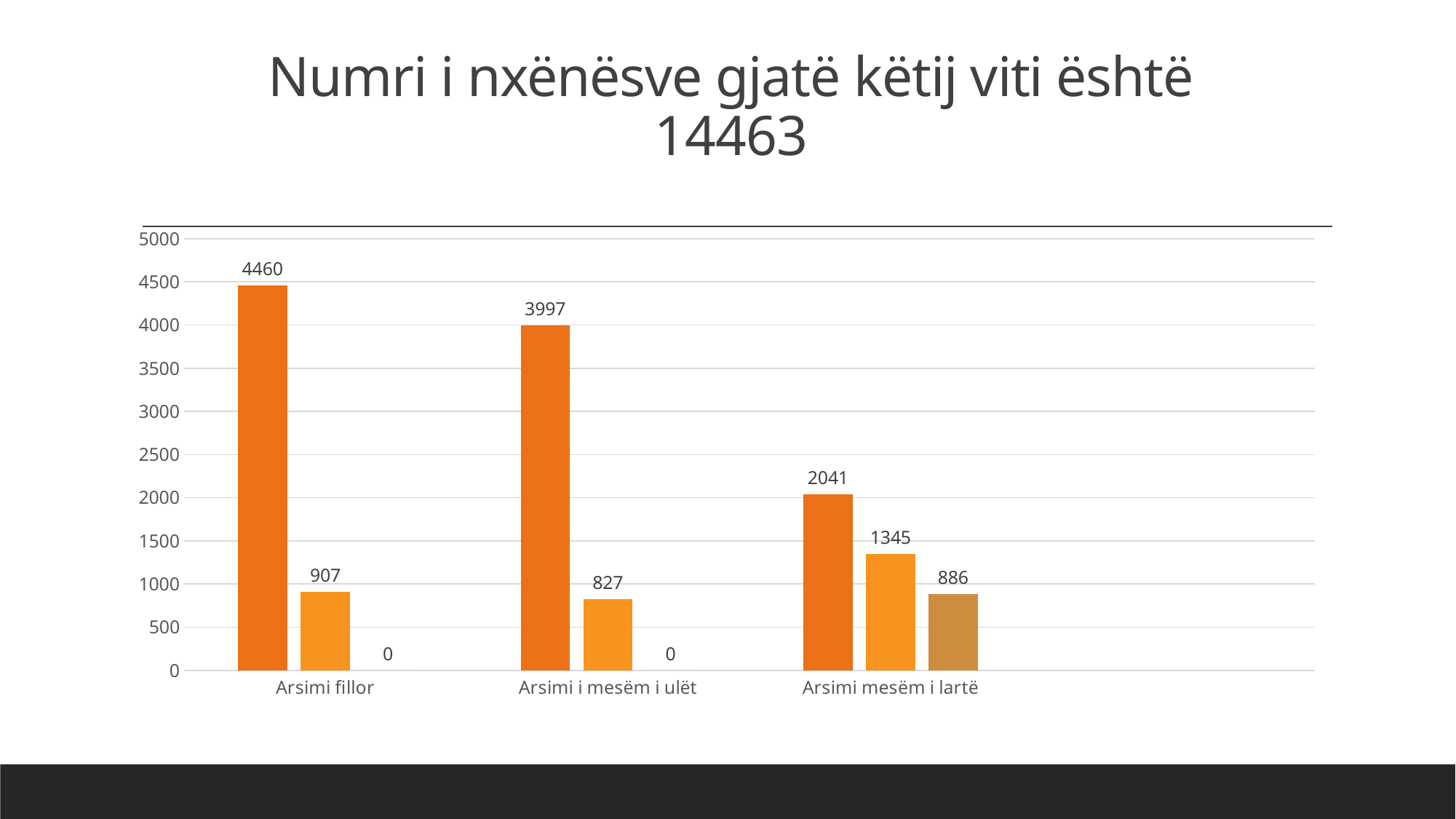
What is the difference between the dark orange bars for Arsimi fillor and Arsimi i mesëm i ulët? 463 What is the value of the tallest (dark orange) bar for Arsimi i mesëm i ulët? 3997 What is the value of the light orange bar for Arsimi mesëm i lartë? 1345 Which category has the highest dark orange bar? Arsimi fillor Which is larger: the light orange bar for Arsimi fillor or the light orange bar for Arsimi i mesëm i ulët? Arsimi fillor Do the dark orange bars rise or fall from left to right across the categories? fall What is the value of the brown bar for Arsimi mesëm i lartë? 886 What kind of chart is shown on the slide? bar chart Which category has the lowest dark orange bar? Arsimi mesëm i lartë How many categories are shown on the x axis? 3 What is the title of the chart? Numri i nxënësve gjatë këtij viti është 14463 What is the value of the tallest (dark orange) bar for Arsimi fillor? 4460